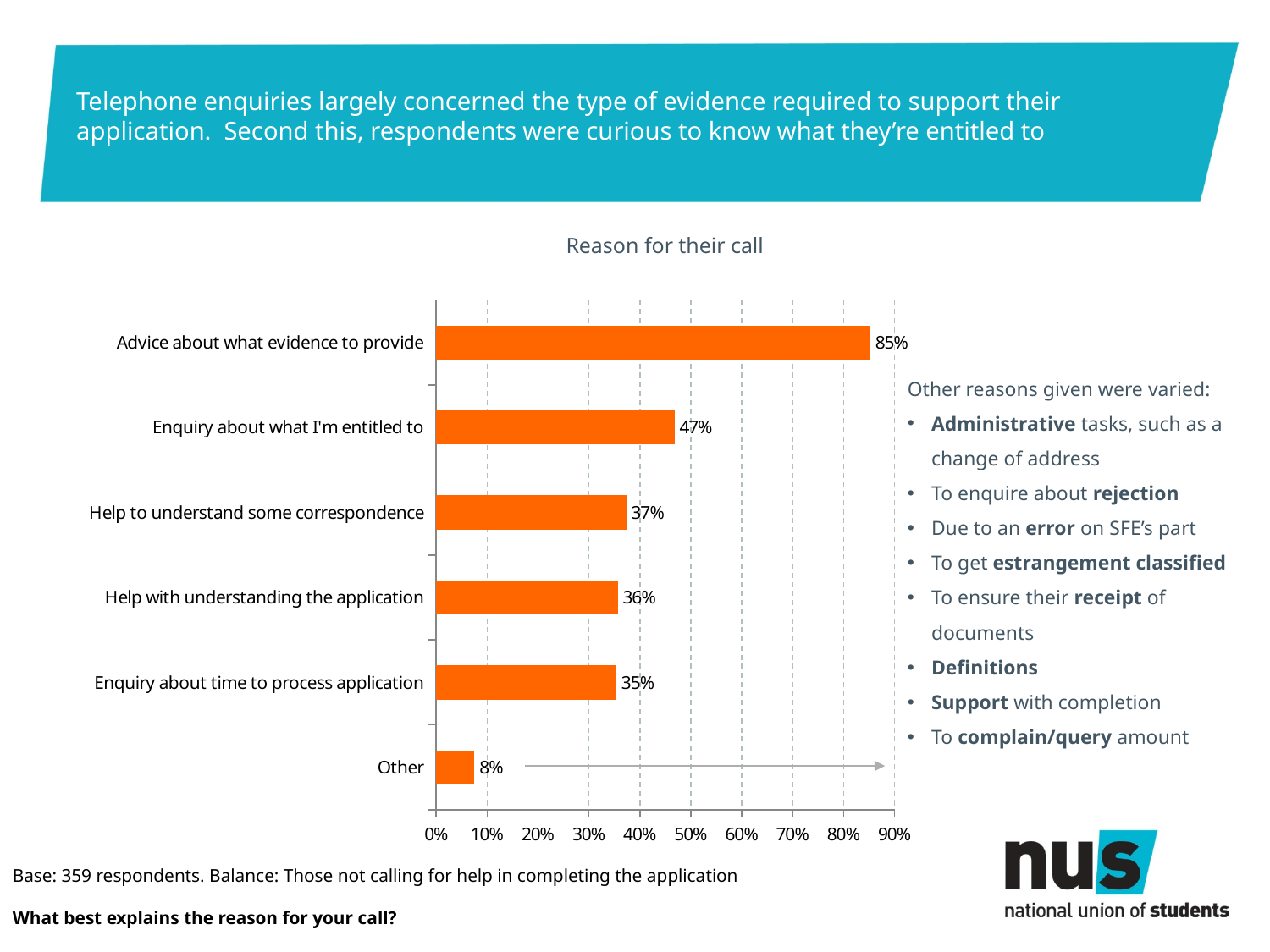
How many reasons for calling are shown in the chart? 6 Is the value for 'Help to understand some correspondence' greater or less than 40%? less Which reason for calling has the highest percentage? Advice about what evidence to provide What percentage of respondents called for advice about what evidence to provide? 85% Which is larger: 'Help with understanding the application' or 'Enquiry about time to process application'? Help with understanding the application What is the value for 'Other'? 8% What percentage called for help to understand some correspondence? 37% What is the title of the chart? Reason for their call What is the value for 'Enquiry about what I'm entitled to'? 47% Which reason for calling has the lowest percentage? Other What is the difference between 'Advice about what evidence to provide' and 'Enquiry about what I'm entitled to'? 38 percentage points What type of chart is shown on the slide? Bar chart